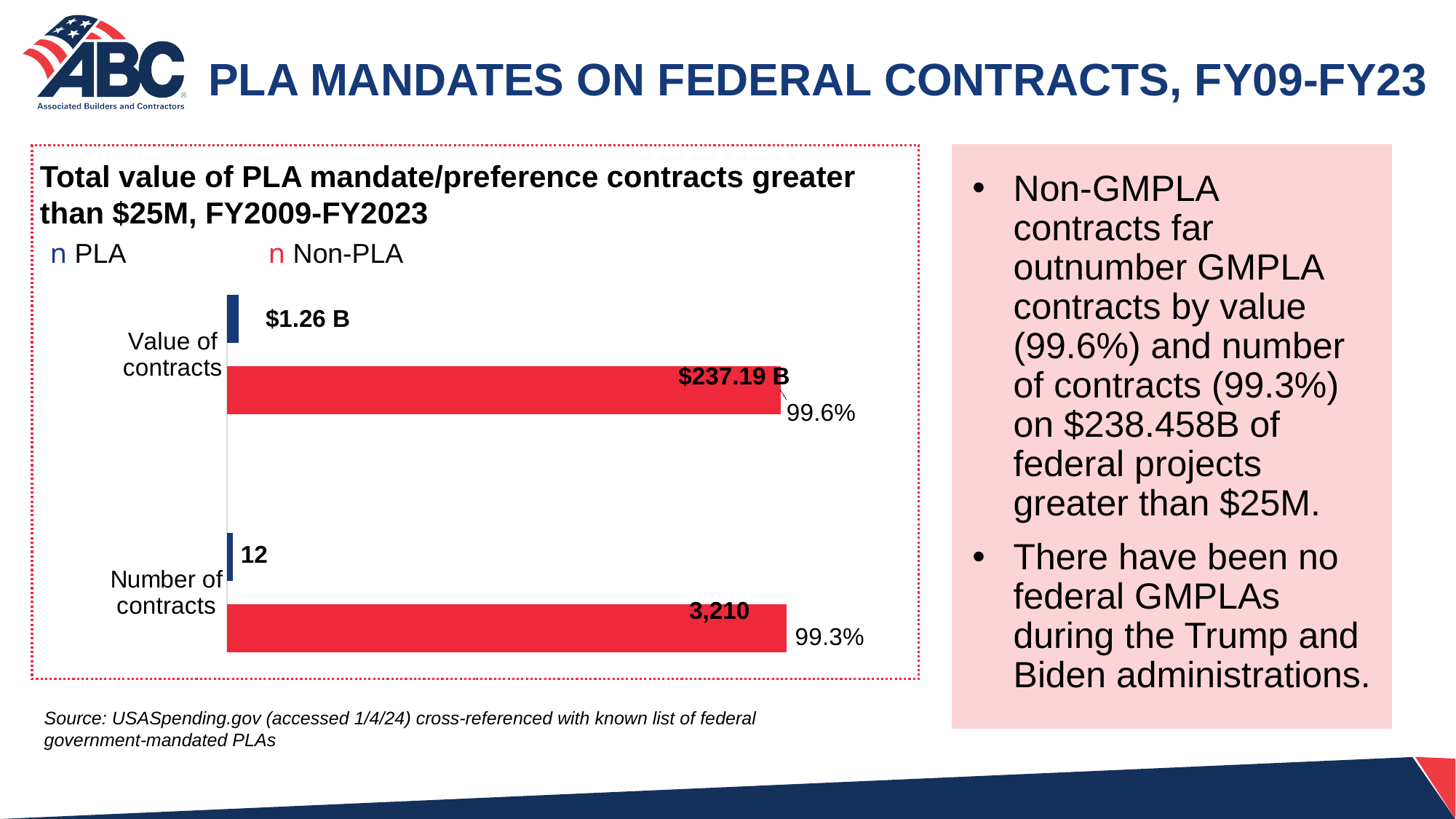
What percentage share is shown next to the Non-PLA bar for value of contracts? 99.6% What percentage share is shown next to the Non-PLA bar for number of contracts? 99.3% What is the value of contracts for Non-PLA? $237.19 B What is the number of contracts for Non-PLA? 3,210 How many series does the legend list? 2 What is the difference in number of contracts between Non-PLA and PLA? 3,198 Which series has the smaller value of contracts? PLA How many categories are shown on the chart? 2 What is the number of contracts for PLA? 12 What is the value of contracts for PLA? $1.26 B What type of chart is shown? Bar chart Which series has the larger number of contracts, PLA or Non-PLA? Non-PLA